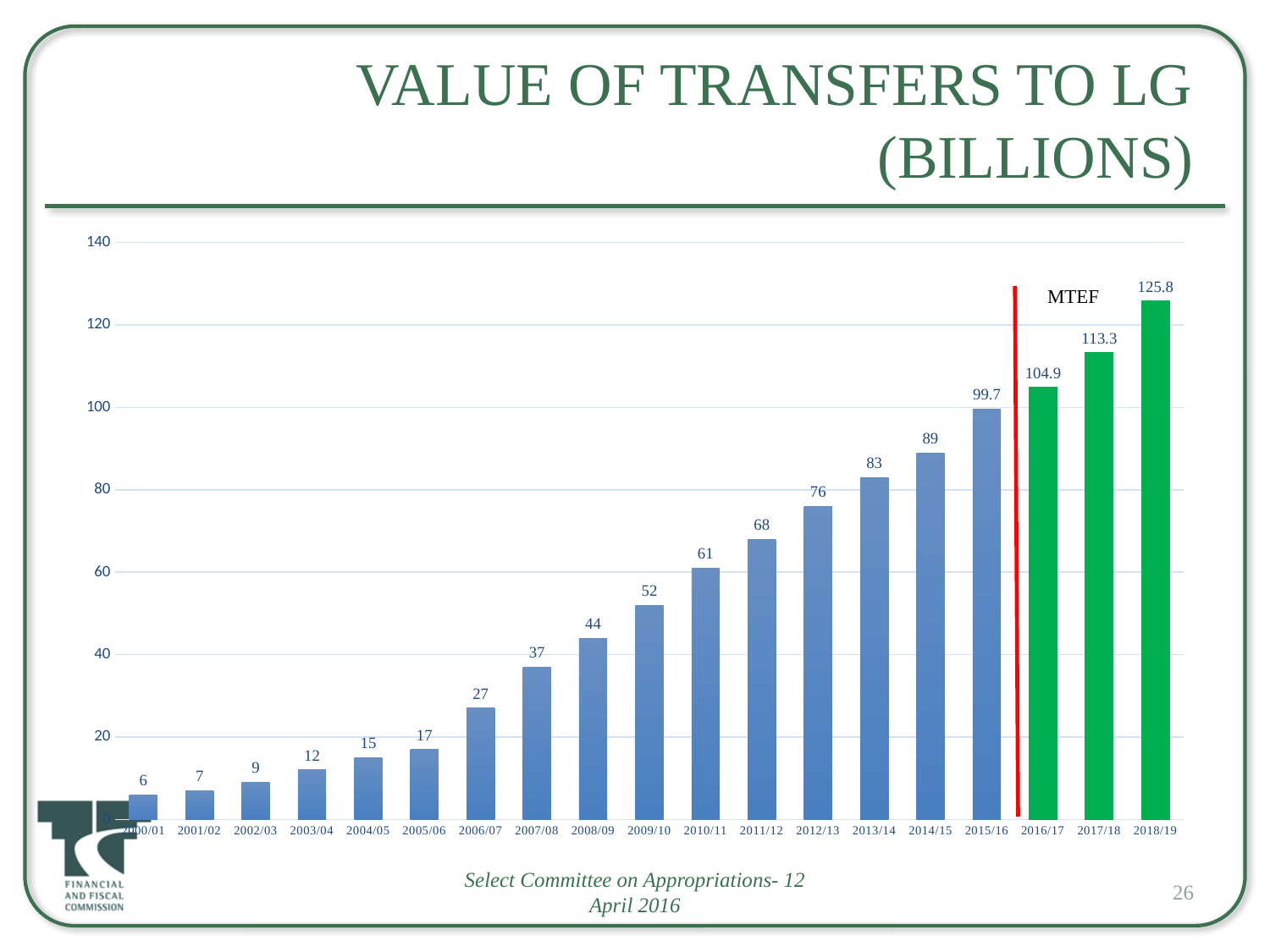
What kind of chart is shown on the slide? Bar chart What is the value of transfers to LG for 2015/16? 99.7 Which is larger, the value for 2013/14 or the value for 2011/12? 2013/14 What is the value shown for 2018/19? 125.8 What is the difference between the values for 2012/13 and 2007/08? 39 Which year has the highest value of transfers to LG? 2018/19 Do the values rise or fall from 2001/02 to 2018/19? Rise How many years are shown on the x axis of the chart? 19 Is the value for 2014/15 greater or less than 100? less What is the value shown for 2009/10? 52 What is the value shown for 2016/17? 104.9 What is the difference between the values for 2017/18 and 2016/17? 8.4